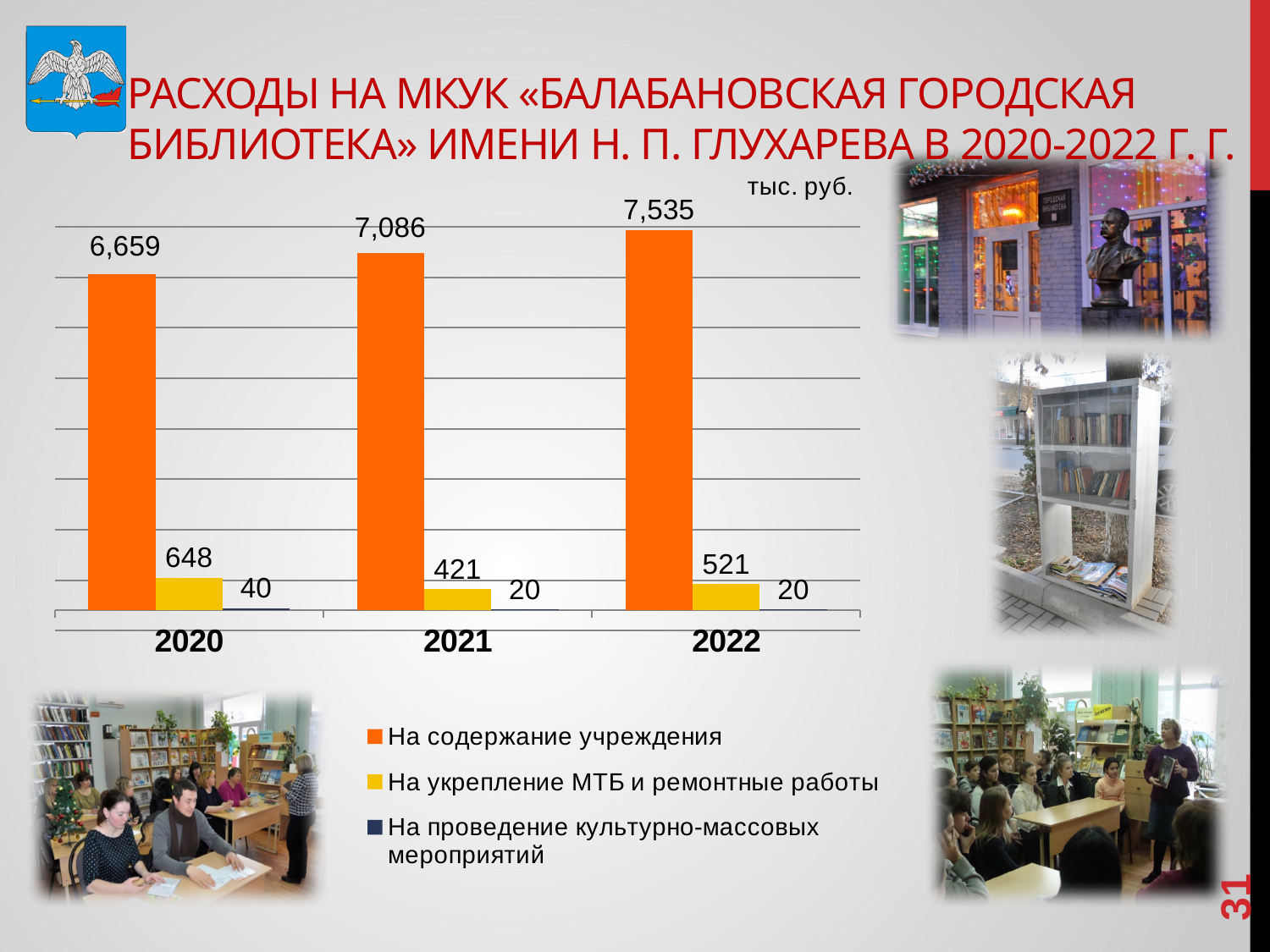
What is the difference between «На укрепление МТБ и ремонтные работы» in 2022 and in 2021? 100 How many years are shown on the x axis of the chart? 3 In which year was spending on «На укрепление МТБ и ремонтные работы» the lowest? 2021 What was the value for «На укрепление МТБ и ремонтные работы» in 2020? 648 What kind of chart is shown on the slide? Bar chart What was the value for «На проведение культурно-массовых мероприятий» in 2021? 20 Which is larger: «На укрепление МТБ и ремонтные работы» in 2020 or in 2022? 2020 Does spending on «На содержание учреждения» rise or fall from 2020 to 2022? Rises By how much did spending on «На содержание учреждения» increase from 2020 to 2022? 876 How many series does the legend list? 3 In which year was spending on «На содержание учреждения» the highest? 2022 What was the value for «На содержание учреждения» in 2022? 7,535